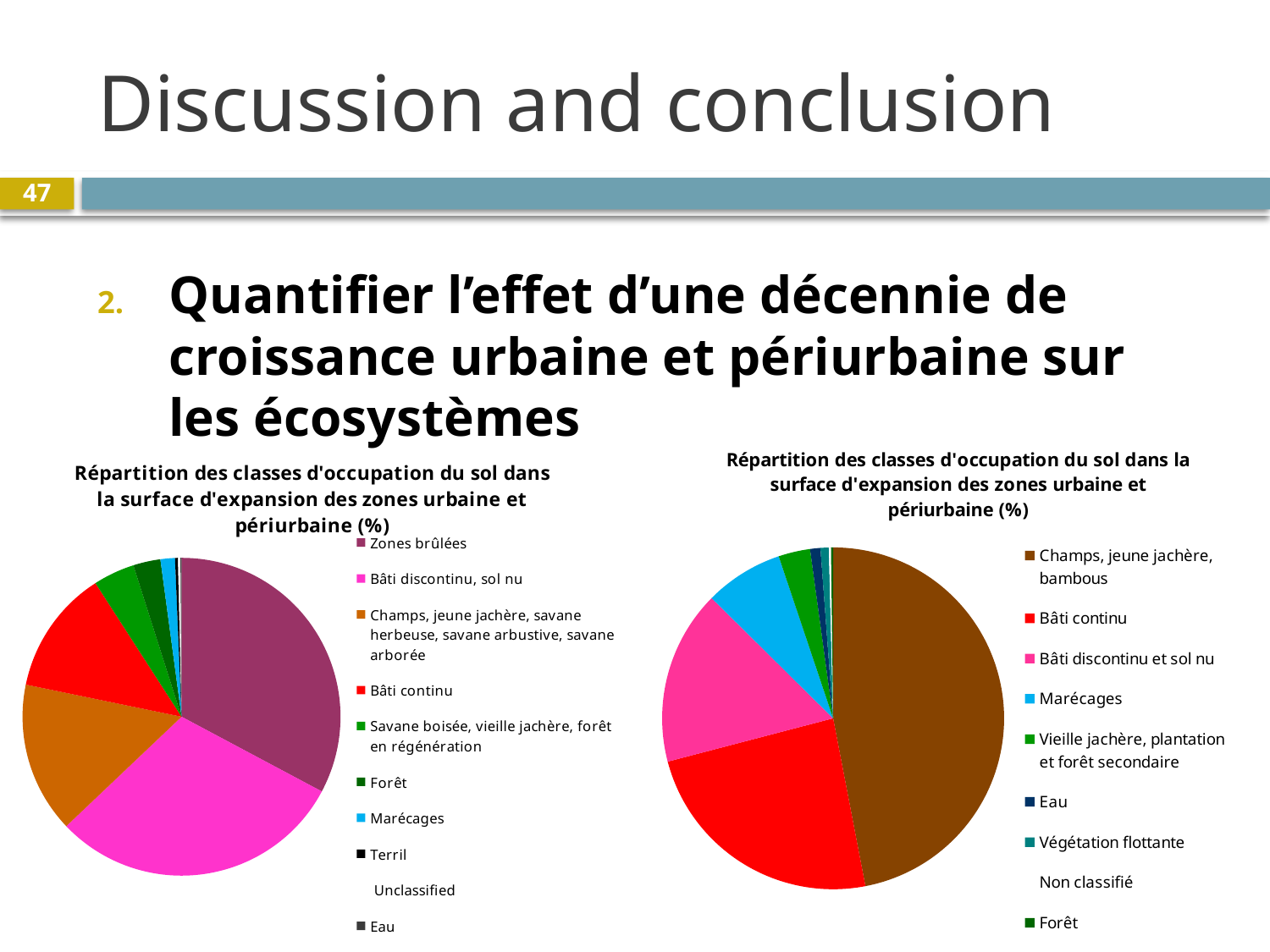
What is the title of the right pie chart? Répartition des classes d'occupation du sol dans la surface d'expansion des zones urbaine et périurbaine (%) How many categories does the legend of the right pie chart list? 9 How many charts are on the slide? 2 In the right pie chart, which category has the largest slice? Champs, jeune jachère, bambous What type of chart is shown on the right of the slide? pie chart In the left pie chart, which slice is larger: Zones brûlées or Forêt? Zones brûlées In the right pie chart, which slice is larger: Bâti continu or Bâti discontinu et sol nu? Bâti continu How many categories does the legend of the left pie chart list? 10 In the right pie chart, which slice is larger: Bâti continu or Marécages? Bâti continu What type of chart is shown on the left of the slide? pie chart In the right pie chart, what colour is the slice for Marécages? light blue